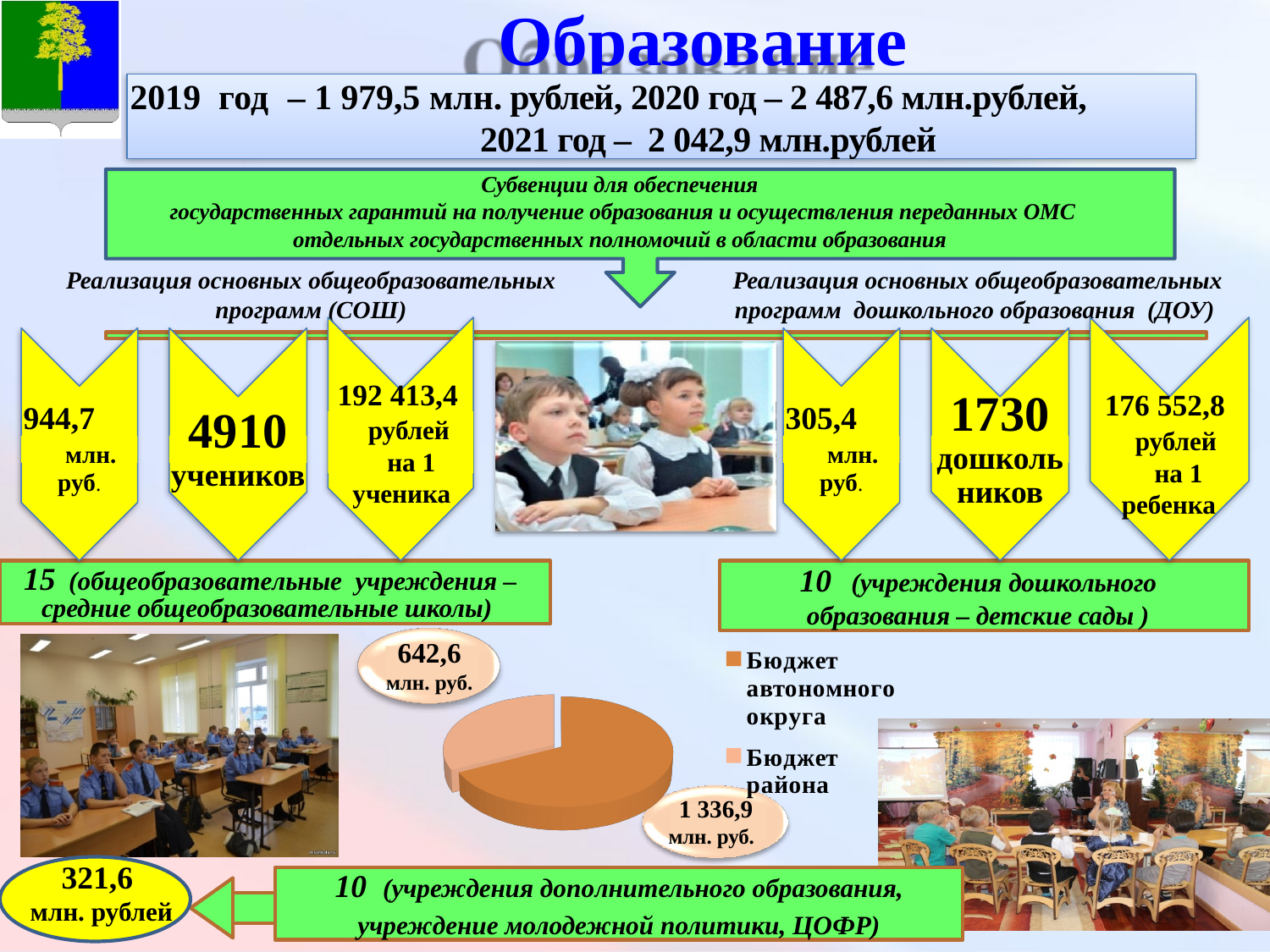
How many entries does the legend of the pie chart list? 2 What is the difference between the Бюджет автономного округа and Бюджет района values in the pie chart? 694,3 млн. руб. What value is shown for Бюджет района in the pie chart? 642,6 млн. руб. Which slice of the pie chart is the largest? Бюджет автономного округа Which slice of the pie chart is the smallest? Бюджет района How many slices does the pie chart have? 2 What value is shown for Бюджет автономного округа in the pie chart? 1 336,9 млн. руб. What is the total of the two values shown in the pie chart? 1 979,5 млн. руб. Which legend entry of the pie chart is shown in the darker orange colour? Бюджет автономного округа Which legend entry of the pie chart is shown in the lighter peach colour? Бюджет района What kind of chart is shown on the slide? pie chart Which is larger in the pie chart: Бюджет автономного округа or Бюджет района? Бюджет автономного округа